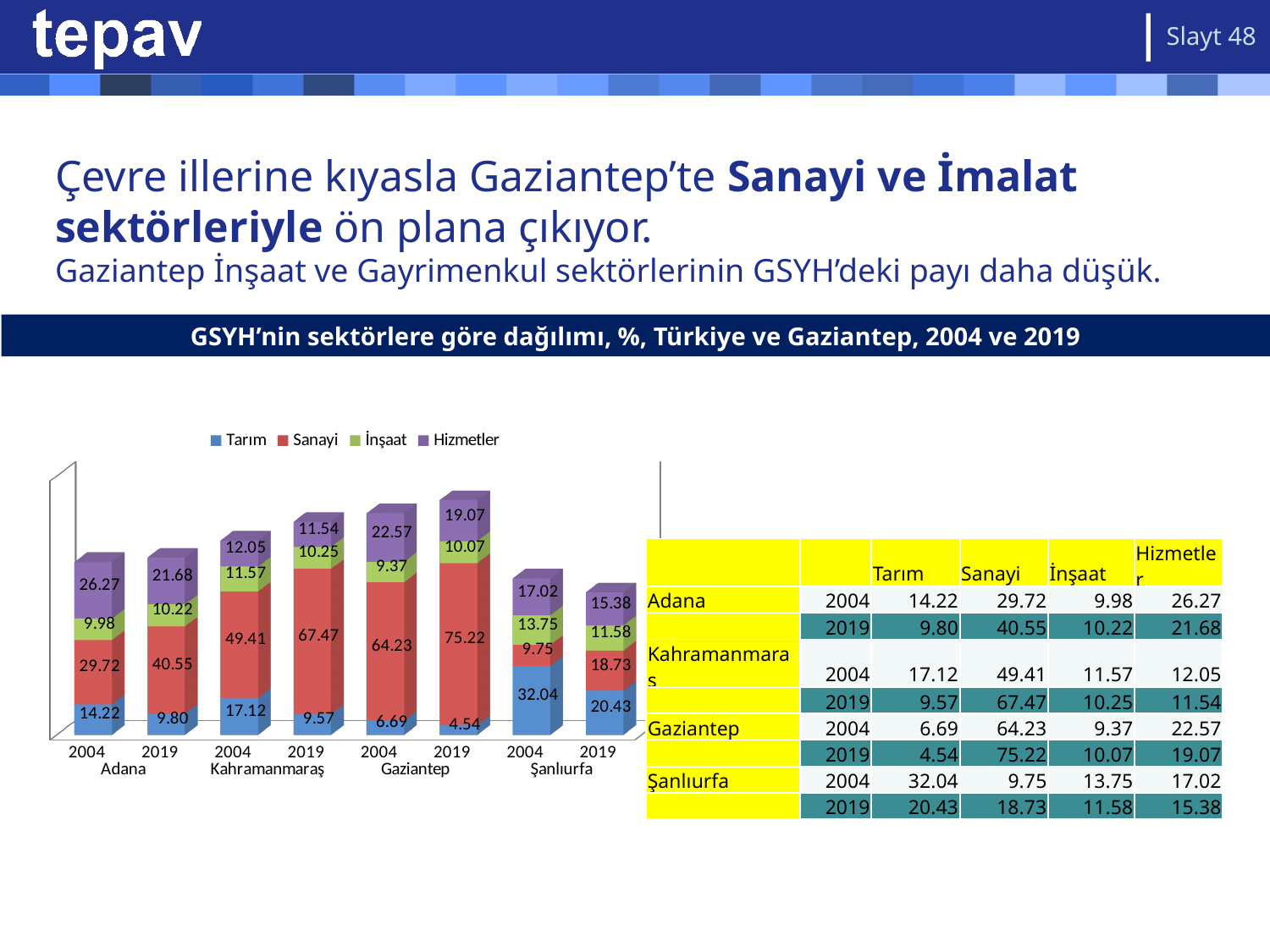
What is the Sanayi value for Gaziantep in 2019? 75.22 How many stacked bars are shown in the chart? 8 Which bar has the lowest Tarım value? Gaziantep 2019 How many series does the legend list? 4 Which bar has the highest Sanayi value? Gaziantep 2019 What is the Hizmetler value for Adana in 2004? 26.27 What is the difference between the Hizmetler values for Adana in 2004 and 2019? 4.59 What is the Tarım value for Şanlıurfa in 2004? 32.04 Does the Sanayi value for Gaziantep rise or fall from 2004 to 2019? Rise By how much did the Sanayi value for Gaziantep increase from 2004 to 2019? 10.99 Which is larger, the Tarım value for Adana in 2004 or for Kahramanmaraş in 2004? Kahramanmaraş 2004 What kind of chart is shown on the slide? Stacked bar chart